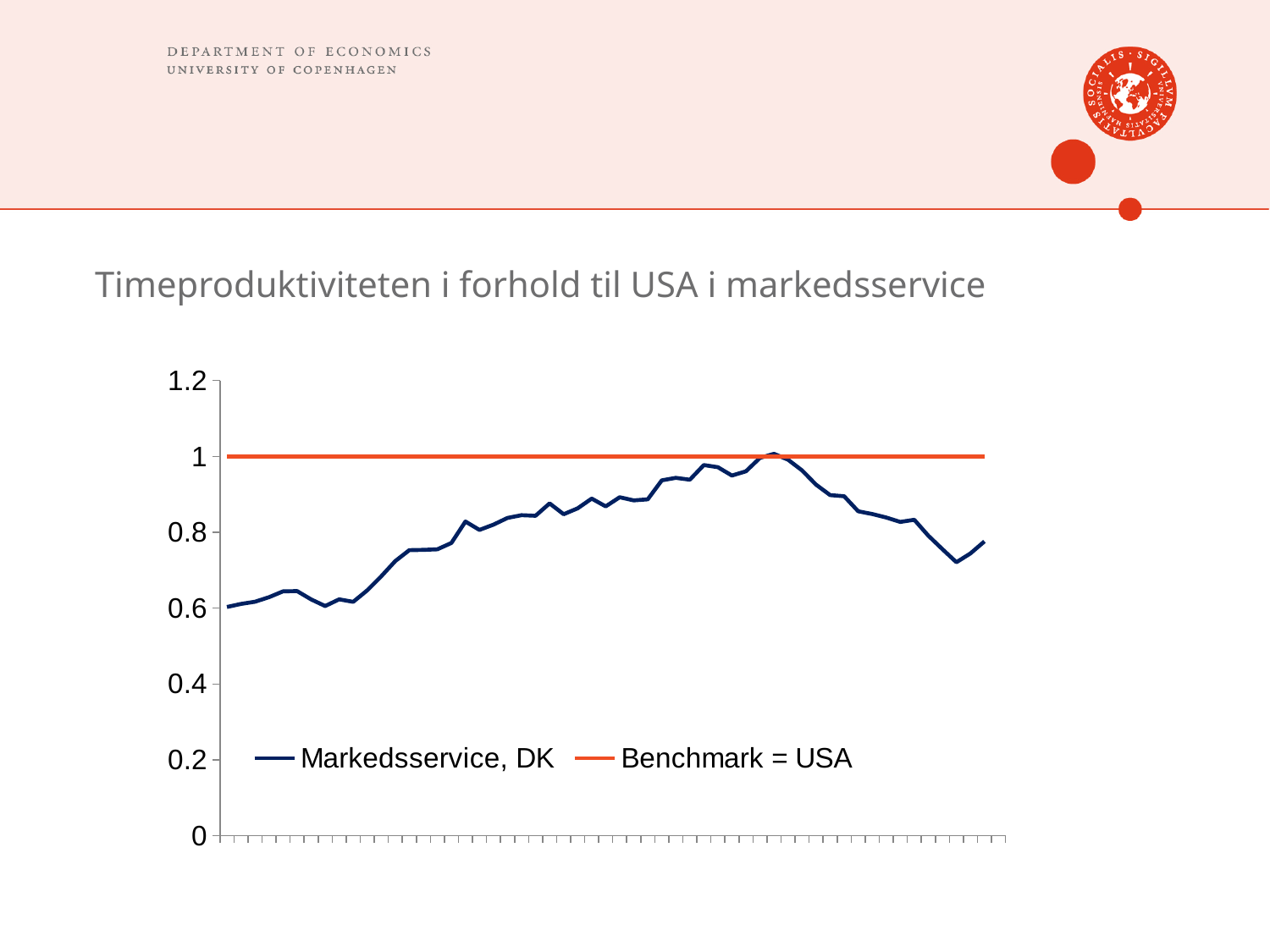
Is the Markedsservice, DK line at any point greater or less than 1.2? less What colour is the Benchmark = USA line? Orange At what value does the Benchmark = USA line sit on the y axis? 1 How many series does the legend list? 2 At the start of the series, which line is higher: Markedsservice, DK or Benchmark = USA? Benchmark = USA Is the lowest value of the Markedsservice, DK line greater or less than 0.4? greater Is the highest value of the Markedsservice, DK line greater or less than 0.8? greater Does the Markedsservice, DK line end higher or lower than it starts? Higher Does the Markedsservice, DK line rise or fall over the first half of the x axis? Rises What kind of chart is shown on the slide? Line chart What is the title of the chart? Timeproduktiviteten i forhold til USA i markedsservice Does the Benchmark = USA line rise, fall or stay flat along the x axis? Stays flat